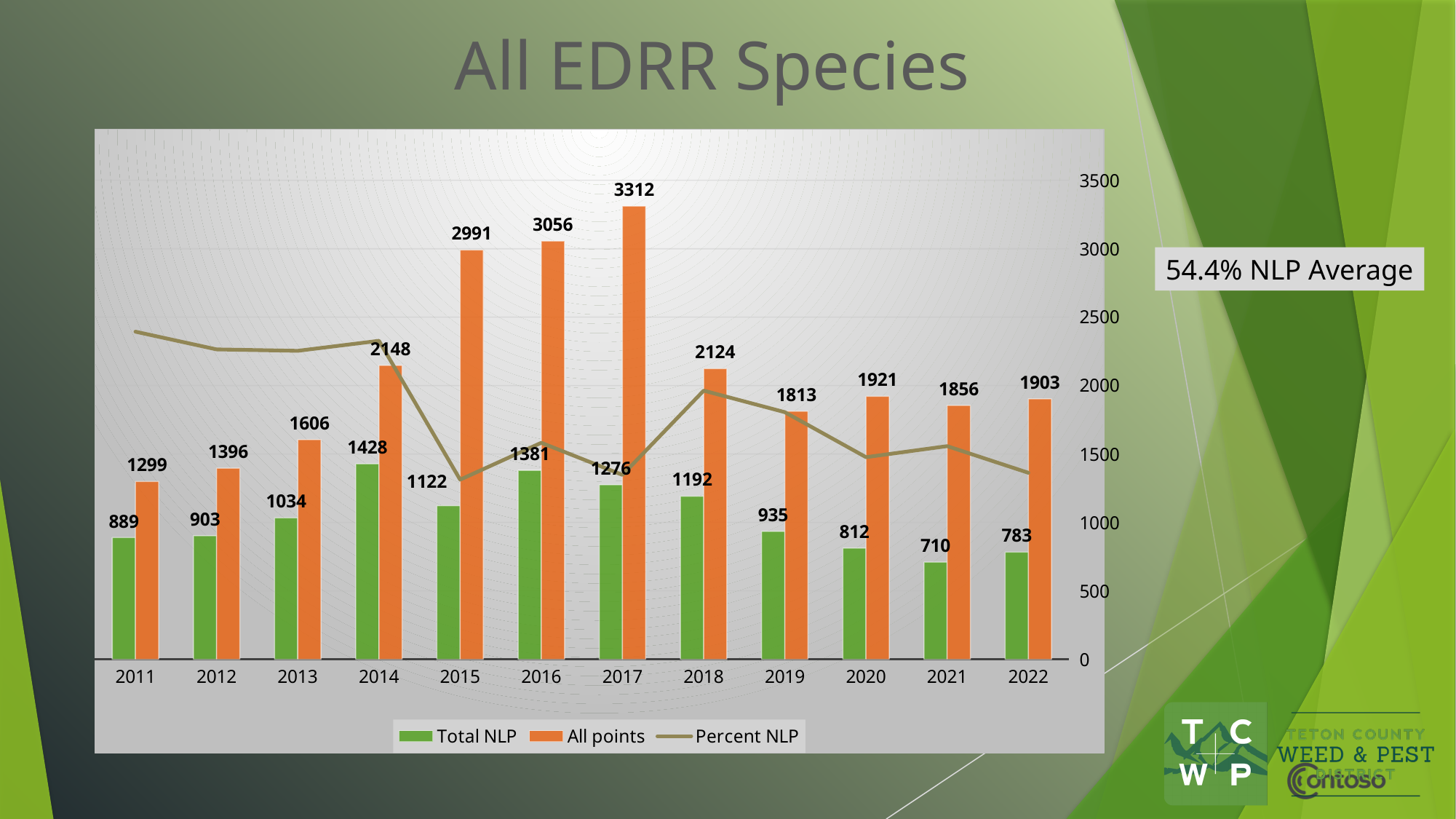
What is the difference between All points and Total NLP in 2016? 1675 What kind of chart is used for the Total NLP and All points series? Bar chart Which year has the highest All points value? 2017 What is the title of the chart? All EDRR Species Which is larger, the All points value in 2015 or in 2018? 2015 Is the All points value for 2014 greater or less than 2000? greater Which year has the lowest Total NLP value? 2021 What is the value of All points in 2017? 3312 Does the Total NLP value rise or fall from 2018 to 2021? Fall What is the value of Total NLP in 2014? 1428 How many years are shown on the x axis? 12 How many series does the legend list? 3